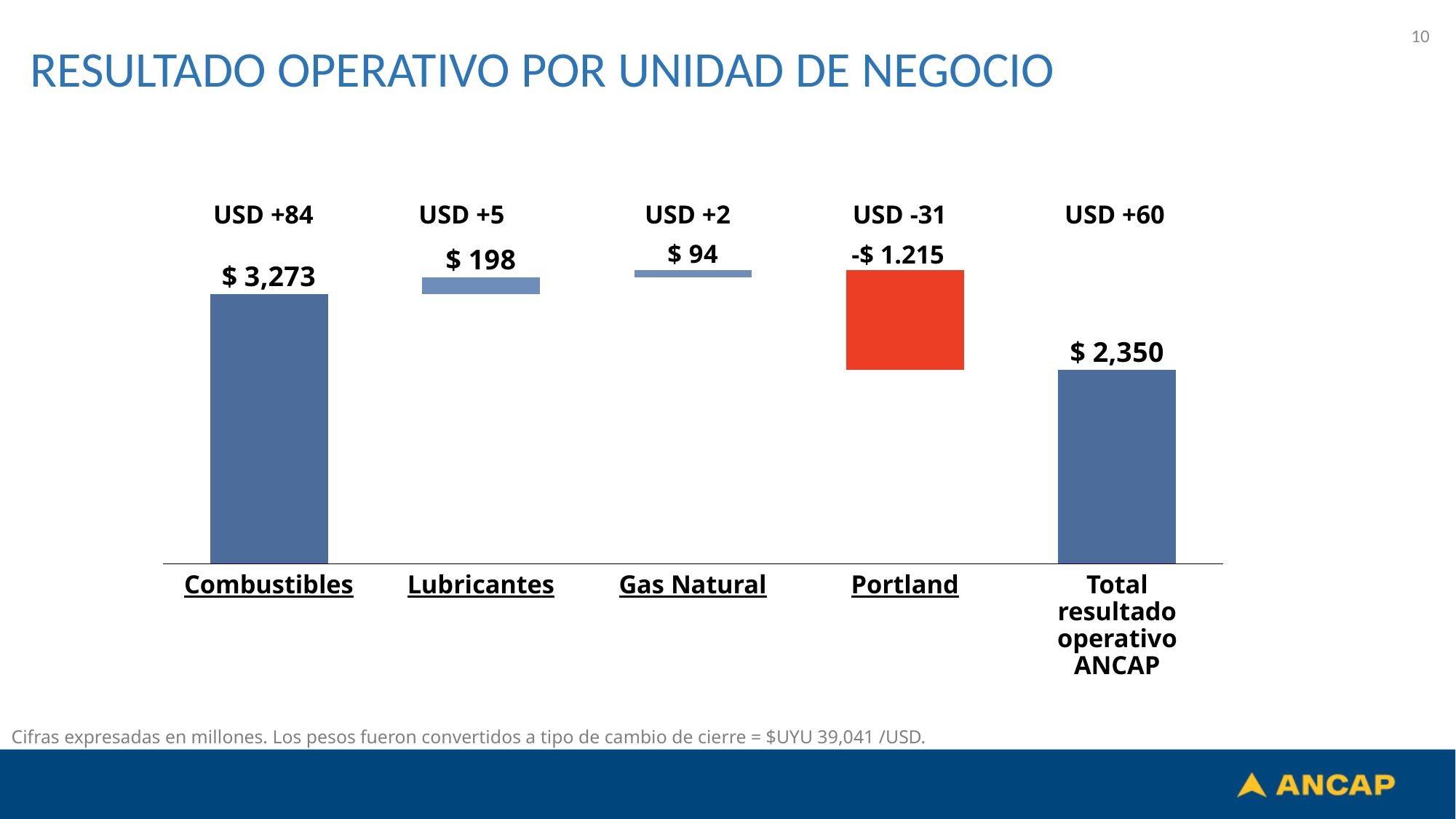
How many categories are shown on the x axis of the chart? 5 What is the value shown for Total resultado operativo ANCAP? $ 2,350 Which business unit has the highest operating result? Combustibles Which business unit has the lowest operating result? Portland What is the difference between the Combustibles value and the Lubricantes value? $ 3,075 What is the value shown for Portland? -$ 1.215 What is the value shown for Combustibles? $ 3,273 What is the difference between the USD figures for Combustibles and Lubricantes? USD 79 Which bar in the chart is coloured red? Portland What is the USD figure shown above the Lubricantes bar? USD +5 What kind of chart is shown on the slide? Bar chart Which is larger, the value for Lubricantes or the value for Gas Natural? Lubricantes